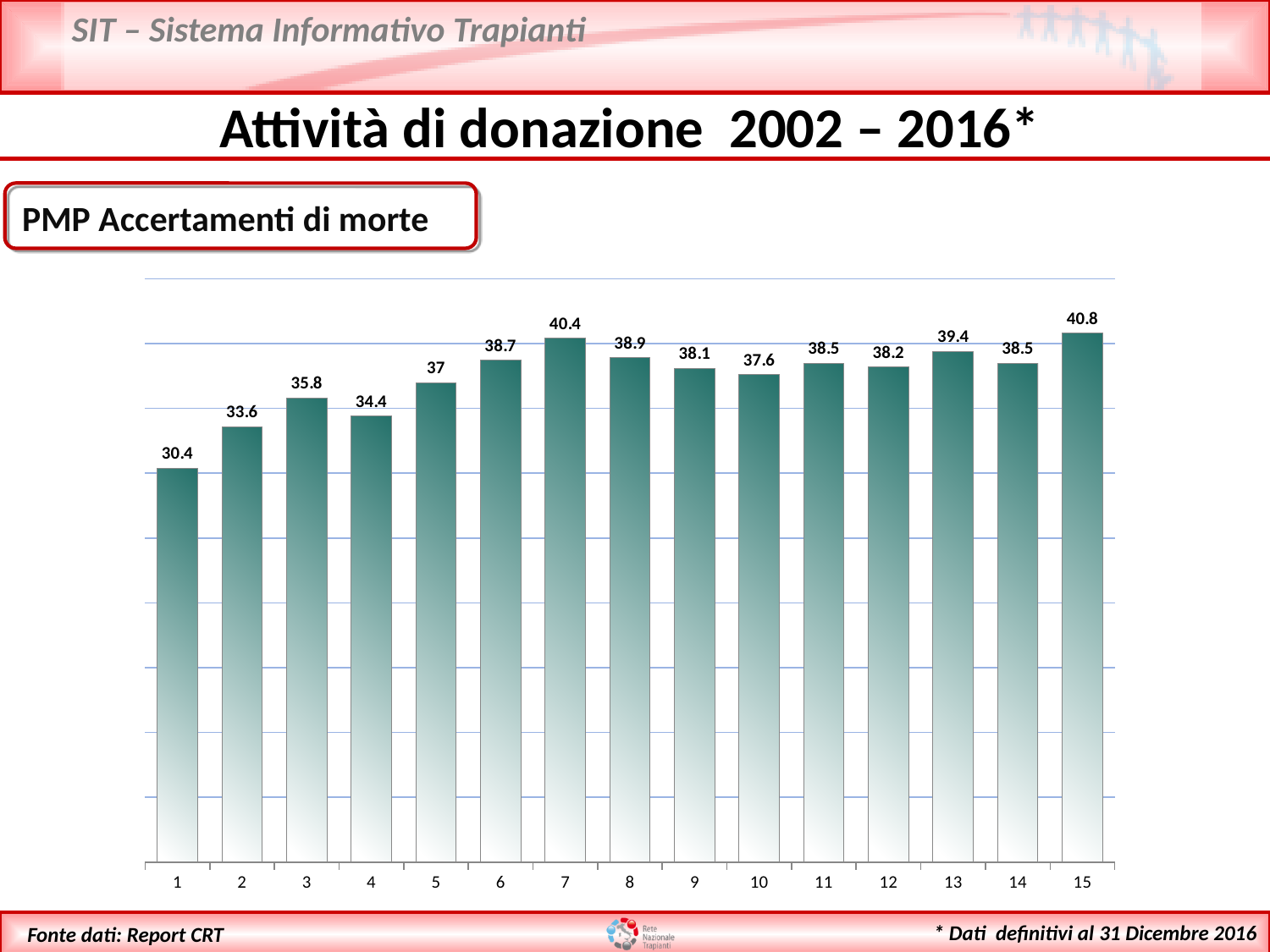
What is the value for category 7? 40.4 Which category has the highest value? 15 What is the difference between the values for category 15 and category 1? 10.4 Which is larger, the value for category 7 or the value for category 15? 15 What is the difference between the values for category 3 and category 4? 1.4 What is the value for category 13? 39.4 What is the value for category 5? 37 How many categories are shown on the x axis? 15 What kind of chart is shown on the slide? bar chart Which category has the lowest value? 1 What is the value for category 1? 30.4 What is the title shown in the box above the chart? PMP Accertamenti di morte